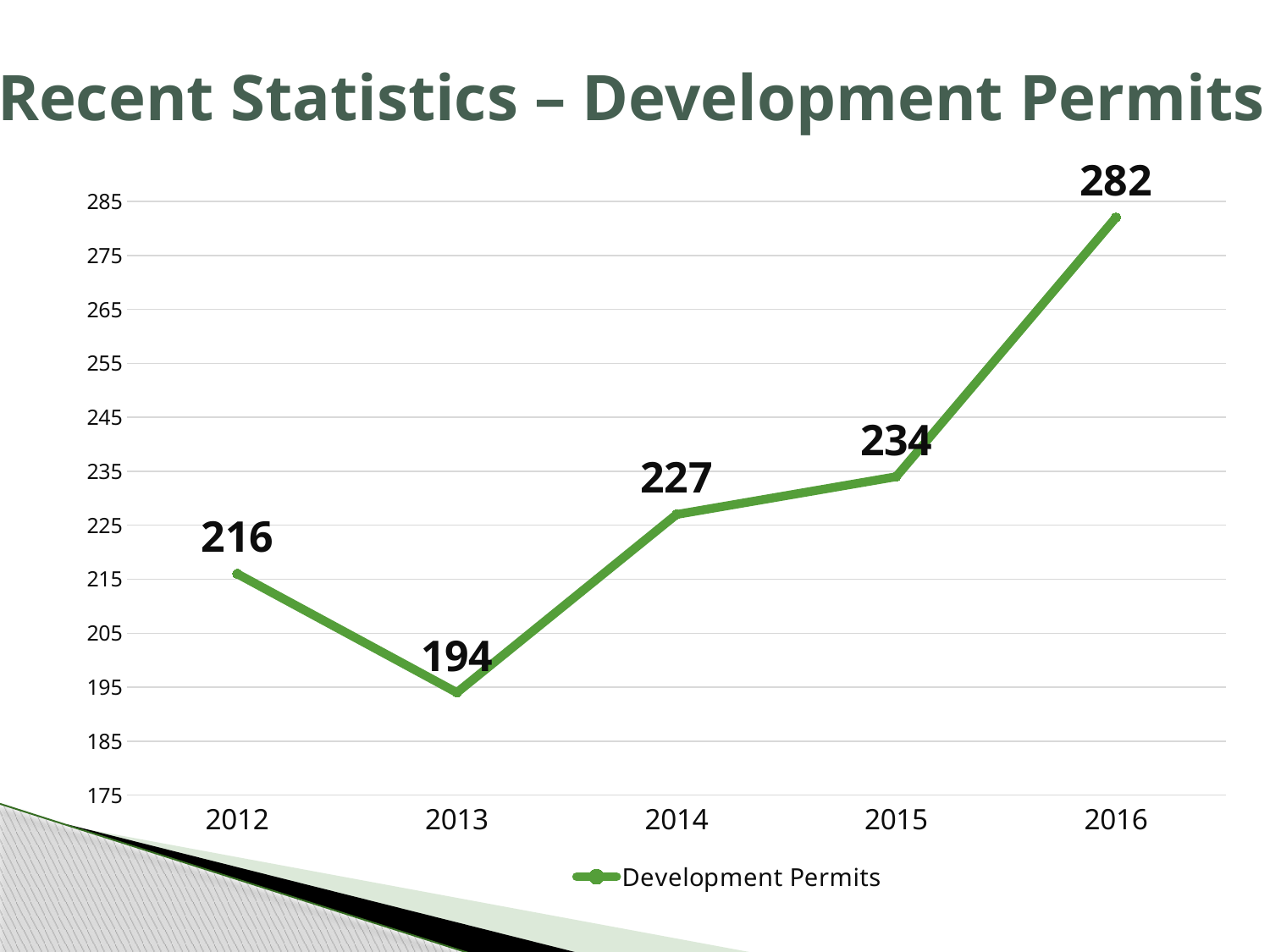
Which year has the lowest number of development permits? 2013 How many years are plotted on the chart? 5 What is the number of development permits in 2016? 282 What is the number of development permits in 2014? 227 What is the difference in development permits between 2012 and 2013? 22 What is the name of the series shown in the legend? Development Permits What is the number of development permits in 2012? 216 Is the value for 2013 greater or less than 205? less What kind of chart is shown on the slide? line chart What is the difference in development permits between 2016 and 2015? 48 Which year had more development permits, 2014 or 2015? 2015 Which year has the highest number of development permits? 2016